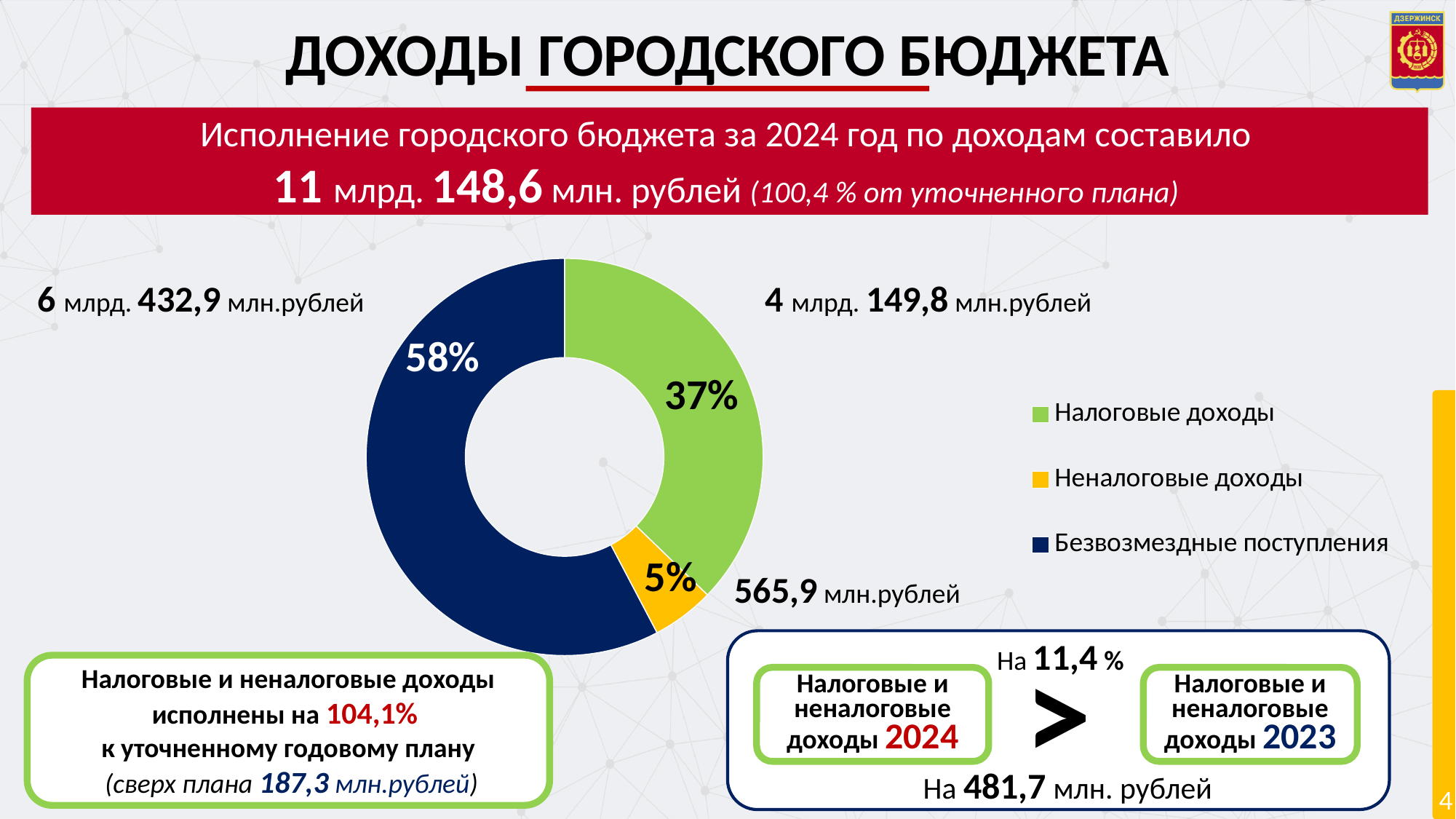
Which category has the smallest share of the pie? Неналоговые доходы What is the value shown for Безвозмездные поступления? 6 млрд. 432,9 млн.рублей What type of chart is shown on the slide? Pie (donut) chart What is the difference in percentage points between the shares of Безвозмездные поступления and Налоговые доходы? 21 percentage points What is the value shown for Неналоговые доходы? 565,9 млн.рублей Which is larger: the share for Налоговые доходы or the share for Безвозмездные поступления? Безвозмездные поступления Which category has the largest share of the pie? Безвозмездные поступления What share of the pie does Неналоговые доходы represent? 5% What share of the pie does Налоговые доходы represent? 37% How many categories does the legend list? 3 What share of the pie does Безвозмездные поступления represent? 58% What is the value shown for Налоговые доходы? 4 млрд. 149,8 млн.рублей